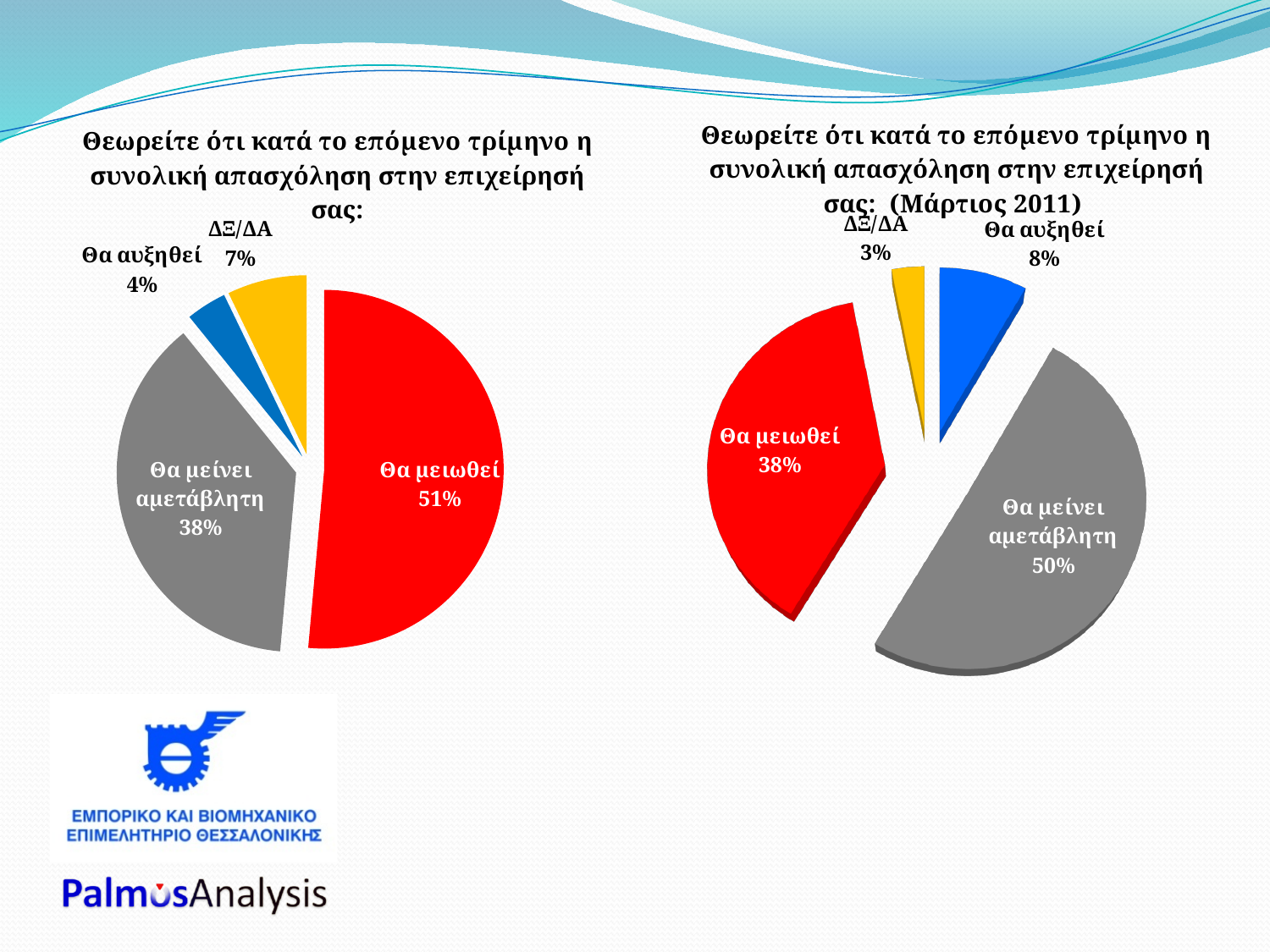
In the right pie chart (Μάρτιος 2011), which category has the smallest share? ΔΞ/ΔΑ In the left pie chart, what colour is the "Θα μειωθεί" slice? Red How many slices does the left pie chart have? 4 In the left pie chart, what share of respondents answered "Θα αυξηθεί"? 4% In the right pie chart (Μάρτιος 2011), what share of respondents answered "ΔΞ/ΔΑ"? 3% In the left pie chart, which category has the largest share? Θα μειωθεί In the right pie chart (Μάρτιος 2011), which is larger: the share for "Θα αυξηθεί" or the share for "ΔΞ/ΔΑ"? Θα αυξηθεί What type of chart is shown on the right side of the slide? Pie chart In the right pie chart (Μάρτιος 2011), what share of respondents answered "Θα μείνει αμετάβλητη"? 50% In the left pie chart, what is the difference between the shares for "Θα μειωθεί" and "Θα μείνει αμετάβλητη"? 13% In the left pie chart, what share of respondents answered "Θα μειωθεί"? 51% In the right pie chart (Μάρτιος 2011), what is the difference between the shares for "Θα μείνει αμετάβλητη" and "Θα μειωθεί"? 12%